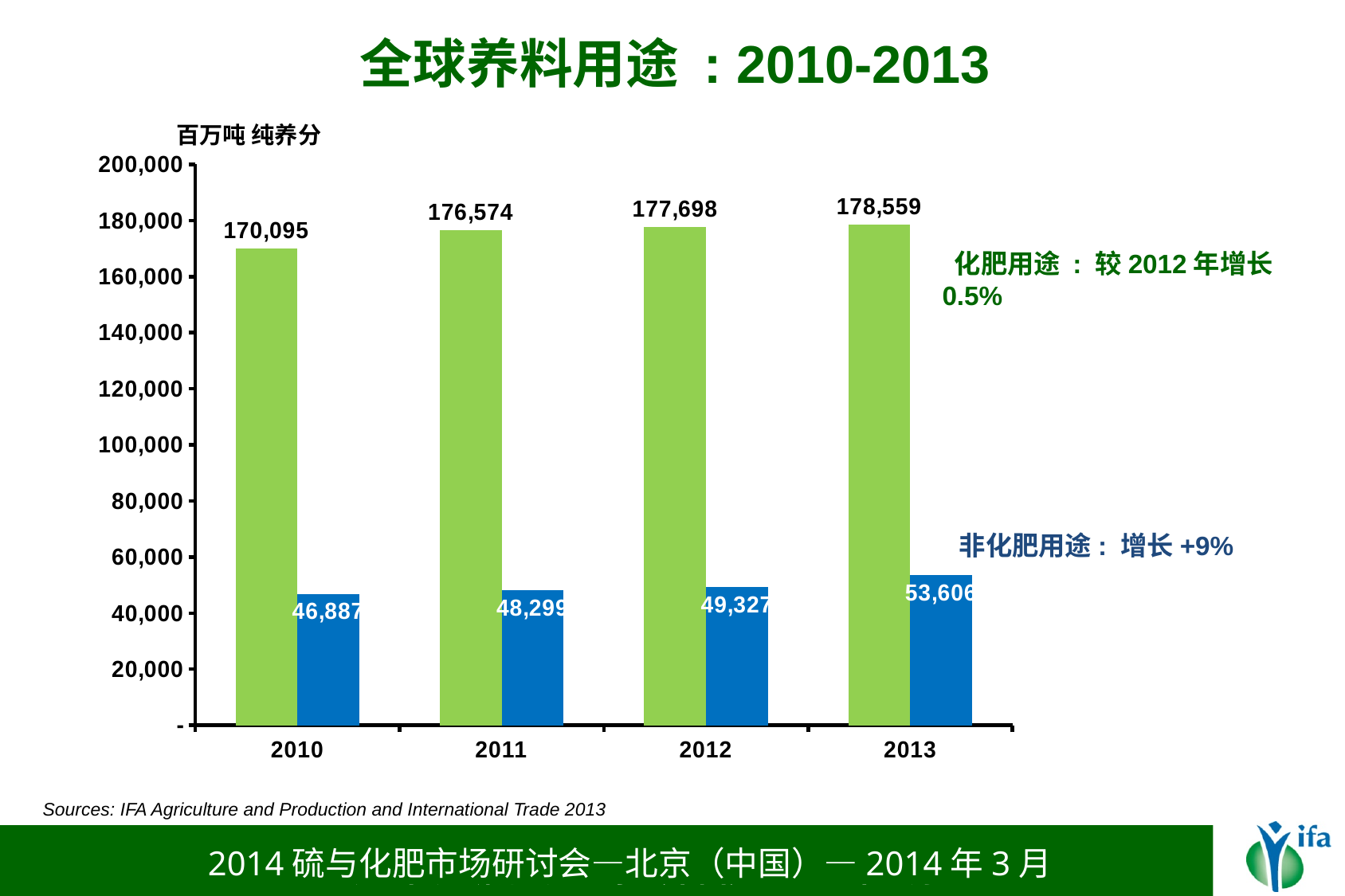
What is the value of the green bar (化肥用途) for 2012? 177,698 What is the difference between the green bar values for 2013 and 2012? 861 What is the value of the green bar (化肥用途) for 2010? 170,095 What is the value of the blue bar (非化肥用途) for 2011? 48,299 Do the green bar (化肥用途) values rise or fall from 2010 to 2013? rise In which year is the blue bar (非化肥用途) lowest? 2010 Which is larger, the blue bar for 2011 or the blue bar for 2012? 2012 What is the difference between the blue bar values for 2013 and 2012? 4,279 How many years are shown on the x axis? 4 Is the value of the blue bar for 2013 greater or less than 60,000? less What is the value of the blue bar (非化肥用途) for 2013? 53,606 In which year is the green bar (化肥用途) highest? 2013